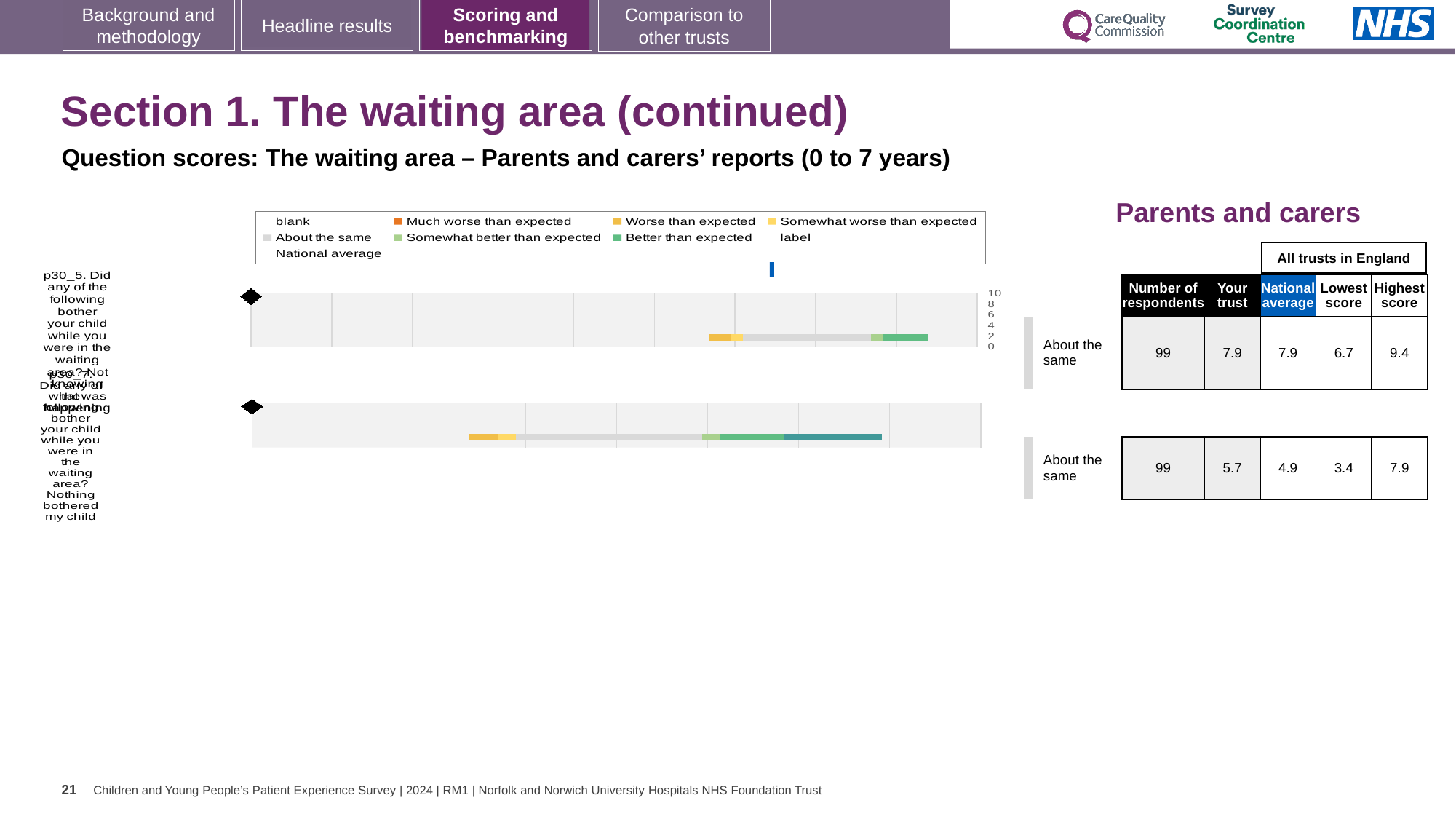
In the table beside the chart, what is the 'Your trust' score for the second question (p30_7)? 5.7 What benchmark category label is shown next to the second bar (p30_7)? About the same In the table beside the chart, for the second question (p30_7), which is larger: the 'Your trust' score or the 'National average'? Your trust How many question bars are plotted in the chart? 2 In the table beside the chart, what is the difference between the 'Your trust' score and the 'National average' for the second question (p30_7)? 0.8 What is the highest tick value shown on the chart's axis? 10 Which legend entry is shown in grey in the chart? About the same In the table beside the chart, what is the number of respondents for the first question (p30_5)? 99 What benchmark category label is shown next to the first bar (p30_5)? About the same What type of chart is shown on the slide? bar chart How many entries does the chart legend list? 9 In the table beside the chart, what is the 'Your trust' score for the first question (p30_5)? 7.9